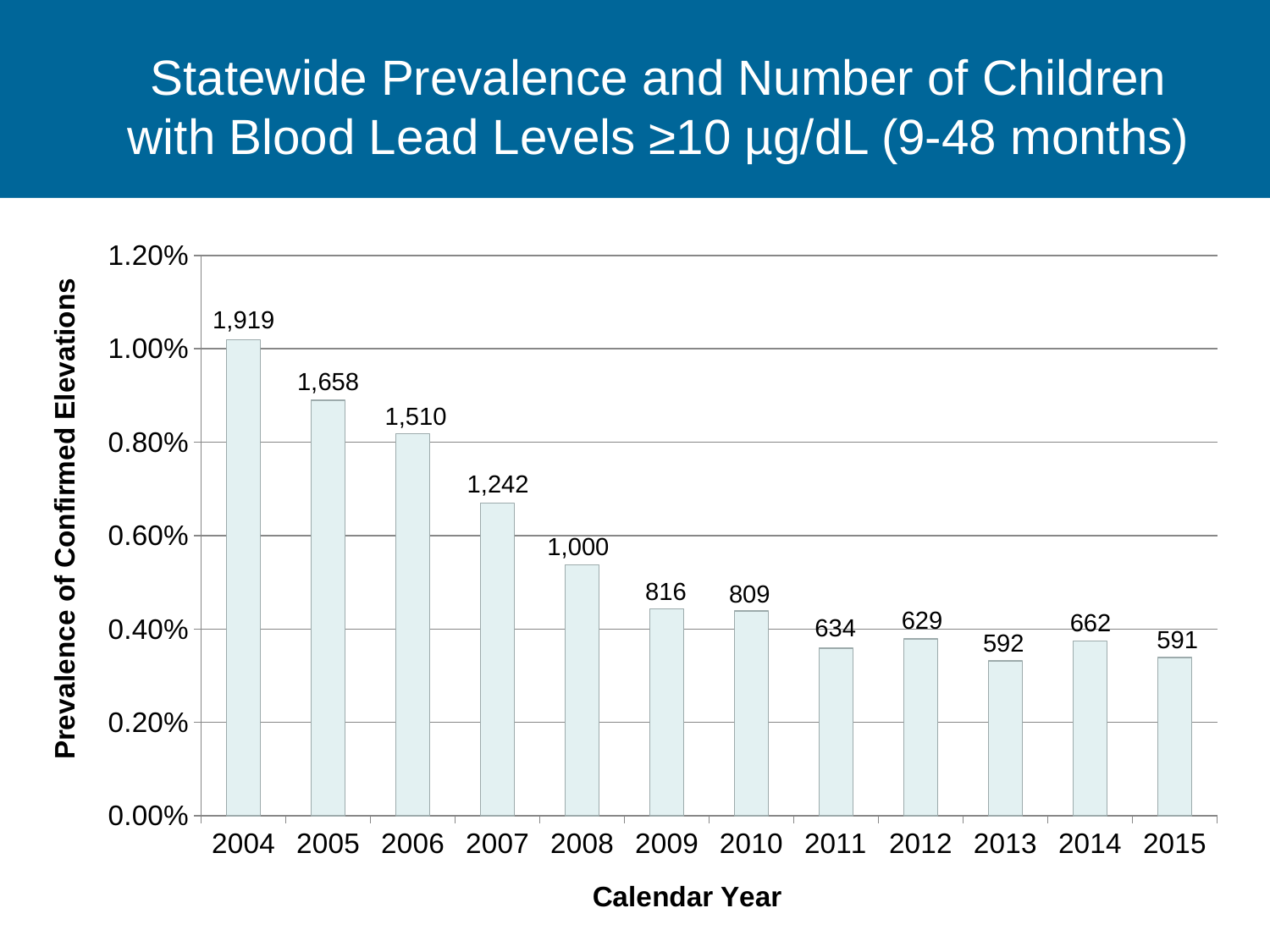
What number of children is labeled on the bar for 2004? 1,919 Which year has a higher prevalence of confirmed elevations, 2006 or 2012? 2006 What kind of chart is shown on the slide? Bar chart Is the prevalence of confirmed elevations for 2011 greater or less than 0.40%? less Which calendar year has the highest prevalence of confirmed elevations? 2004 How many calendar years are shown on the x axis of the chart? 12 Which calendar year has the smallest labeled number of children? 2015 What number of children is labeled on the bar for 2008? 1,000 Overall, does the prevalence of confirmed elevations rise or fall from 2004 to 2015? Fall What is the difference between the labeled number of children in 2009 and in 2010? 7 What number of children is labeled on the bar for 2014? 662 What is the difference between the labeled number of children in 2004 and in 2015? 1,328